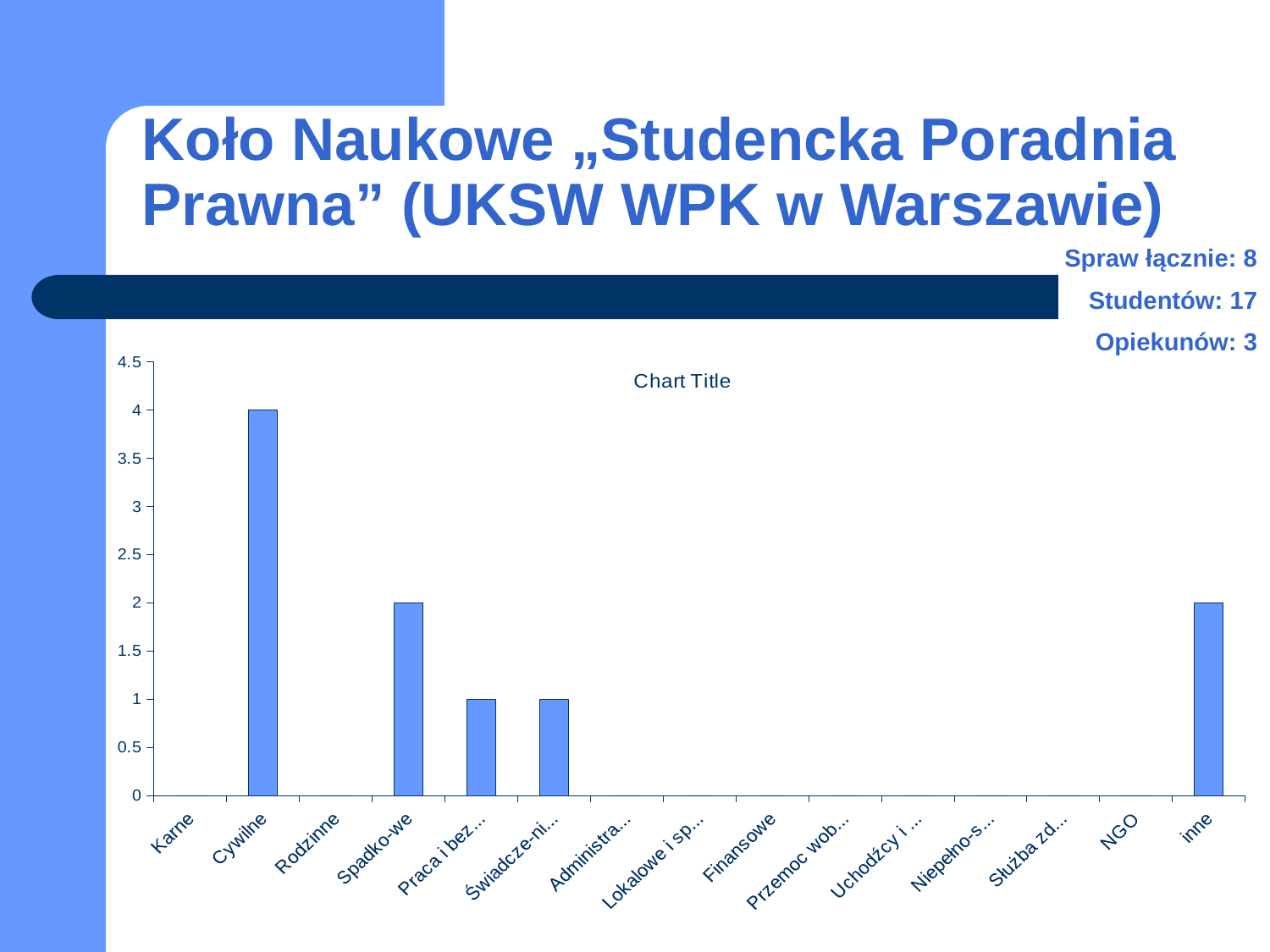
What is the value for Cywilne? 4 How many categories are shown on the x axis? 15 What is the value for inne? 2 What is the highest value shown on the y axis? 4.5 Which category has the highest value? Cywilne Which is larger, the value for Cywilne or the value for inne? Cywilne What is the title shown on the chart? Chart Title What is the difference between the values for Cywilne and Spadko-we? 2 Is the value for Cywilne greater or less than 3? greater What is the value for Spadko-we? 2 What is the value for Świadcze-ni...? 1 What type of chart is shown on the slide? bar chart